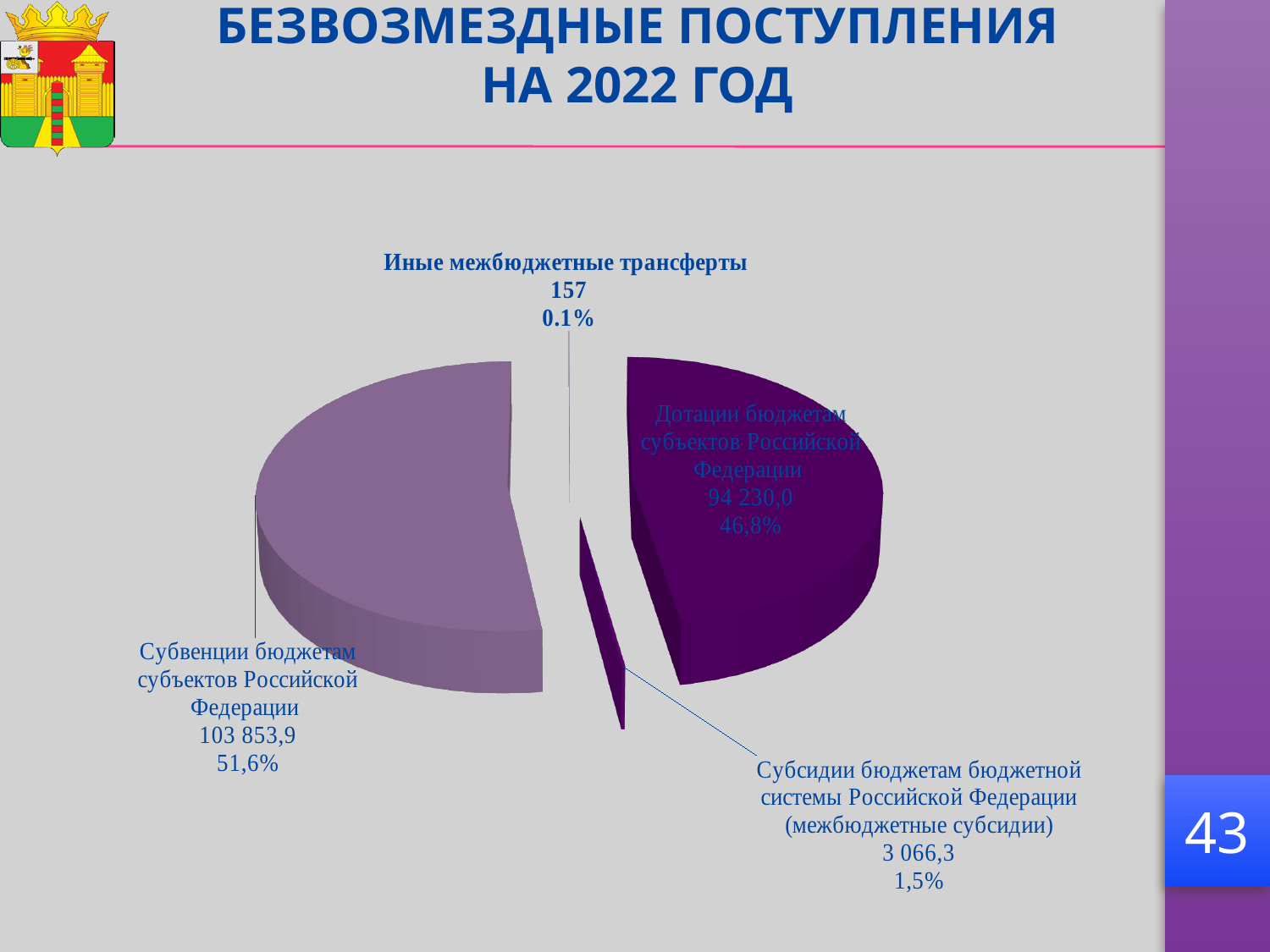
What share of the pie does Субвенции бюджетам субъектов Российской Федерации represent? 51,6% What is the value for Субсидии бюджетам бюджетной системы Российской Федерации (межбюджетные субсидии)? 3 066,3 What is the value for Иные межбюджетные трансферты? 157 Which category has the largest value? Субвенции бюджетам субъектов Российской Федерации What is the value for Субвенции бюджетам субъектов Российской Федерации? 103 853,9 What is the title of the slide containing the chart? БЕЗВОЗМЕЗДНЫЕ ПОСТУПЛЕНИЯ НА 2022 ГОД What type of chart is shown on the slide? Pie chart What is the difference between the values for Субвенции бюджетам субъектов Российской Федерации and Дотации бюджетам субъектов Российской Федерации? 9 623,9 What is the value for Дотации бюджетам субъектов Российской Федерации? 94 230,0 Which category has the smallest value? Иные межбюджетные трансферты How many slices does the pie chart have? 4 What share of the pie does Дотации бюджетам субъектов Российской Федерации represent? 46,8%